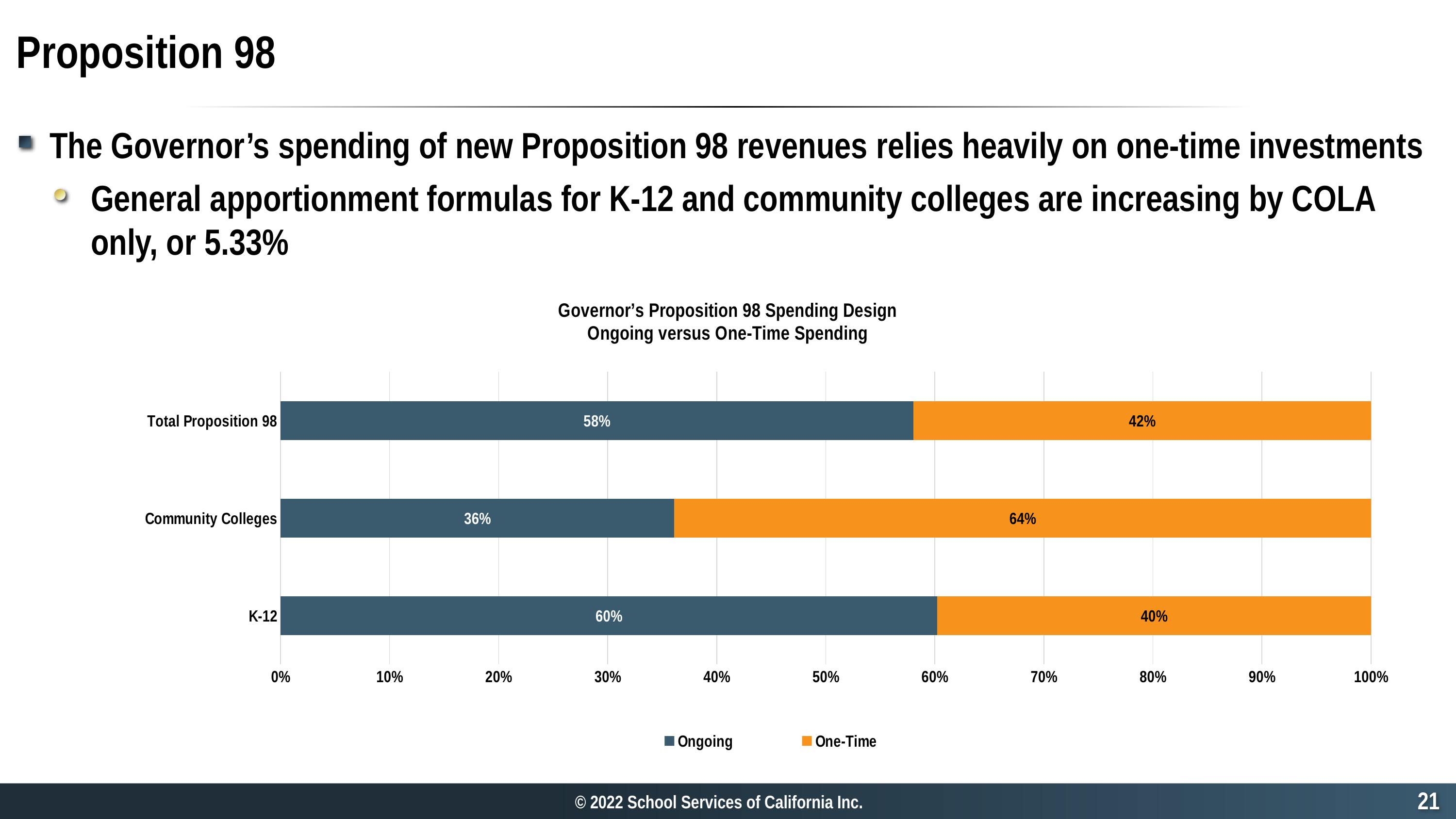
Which category has the lowest Ongoing share? Community Colleges What is the difference between the One-Time values for Community Colleges and K-12? 24% What is the total of the stacked bar for Total Proposition 98? 100% What is the One-Time value for K-12? 40% What is the One-Time value for Community Colleges? 64% What is the Ongoing value for Total Proposition 98? 58% Which category has the highest Ongoing share? K-12 How many series does the legend list? 2 Is the Ongoing value larger for K-12 or for Community Colleges? K-12 How many categories are shown on the chart? 3 What kind of chart is shown on the slide? Stacked bar chart What is the Ongoing value for K-12? 60%